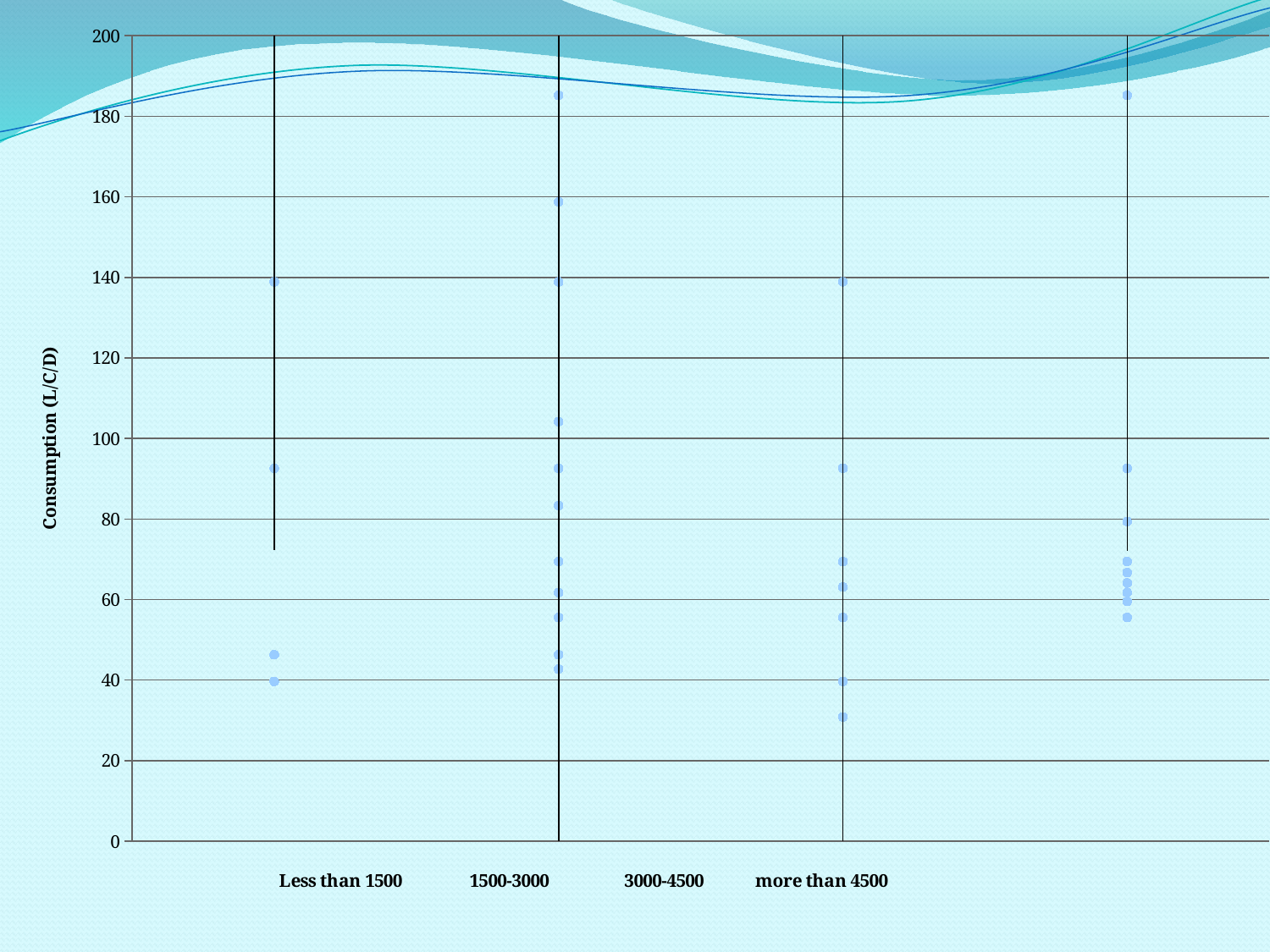
What is the maximum value shown on the y axis? 200 Is the lowest point for 3000-4500 greater or less than 40? less What kind of chart is shown on the slide? scatter plot Is the highest point for 1500-3000 greater or less than 180? greater Is the highest point for Less than 1500 greater or less than 120? greater How many categories are shown along the x axis? 4 Which category has more plotted points, Less than 1500 or 1500-3000? 1500-3000 What is the label of the y axis? Consumption (L/C/D) Which category contains the lowest plotted point on the chart? 3000-4500